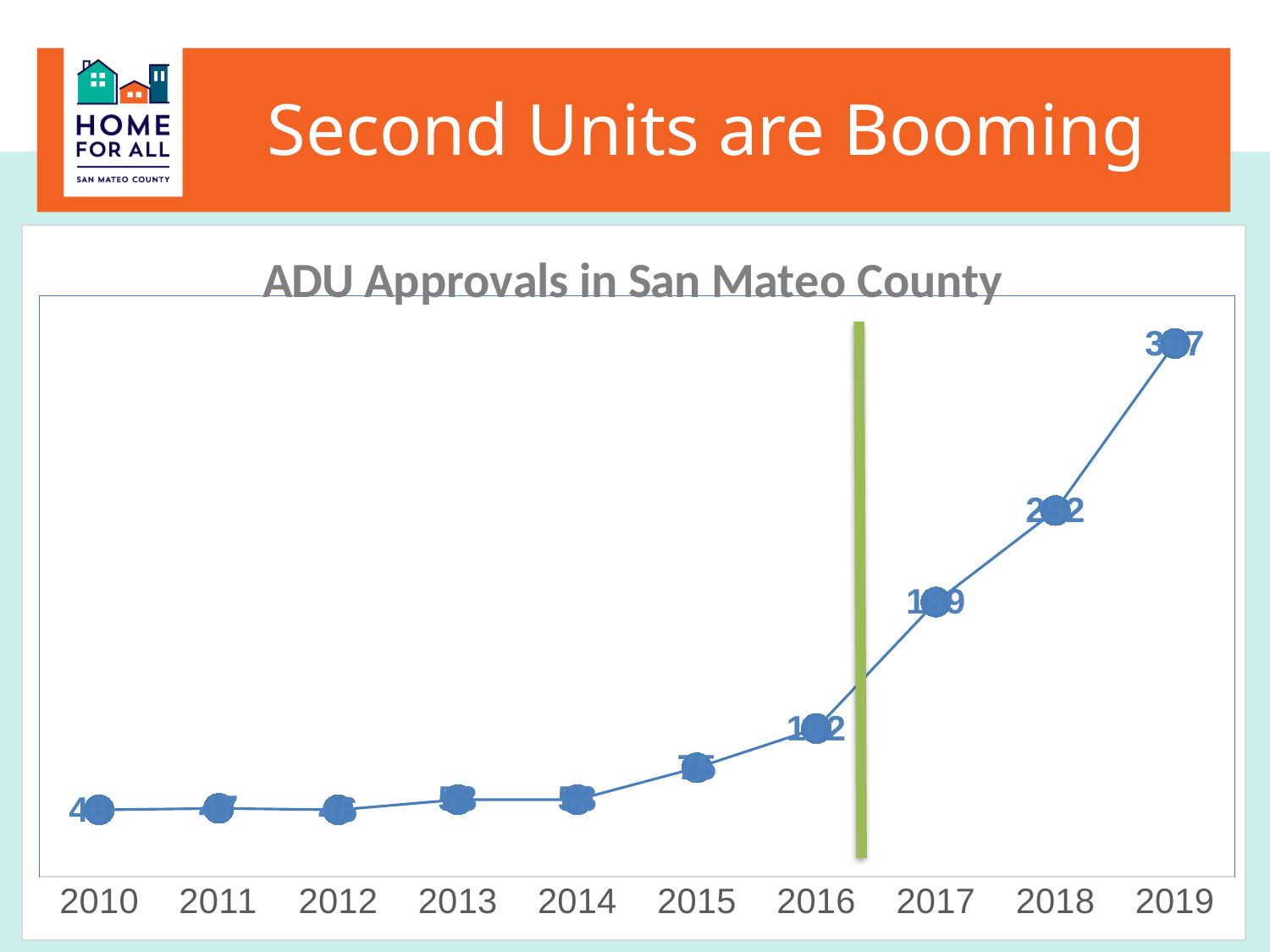
Which year has more ADU approvals, 2017 or 2015? 2017 Which year has more ADU approvals, 2010 or 2019? 2019 How many years are plotted on the x axis of the chart? 10 Which year has the highest number of ADU approvals? 2019 What is the first year shown on the x axis? 2010 Do ADU approvals generally rise or fall from 2010 to 2019? rise Between which two years is the green vertical line placed on the chart? 2016 and 2017 What is the title of the chart? ADU Approvals in San Mateo County What kind of chart is shown on the slide? line chart Which year has more ADU approvals, 2018 or 2016? 2018